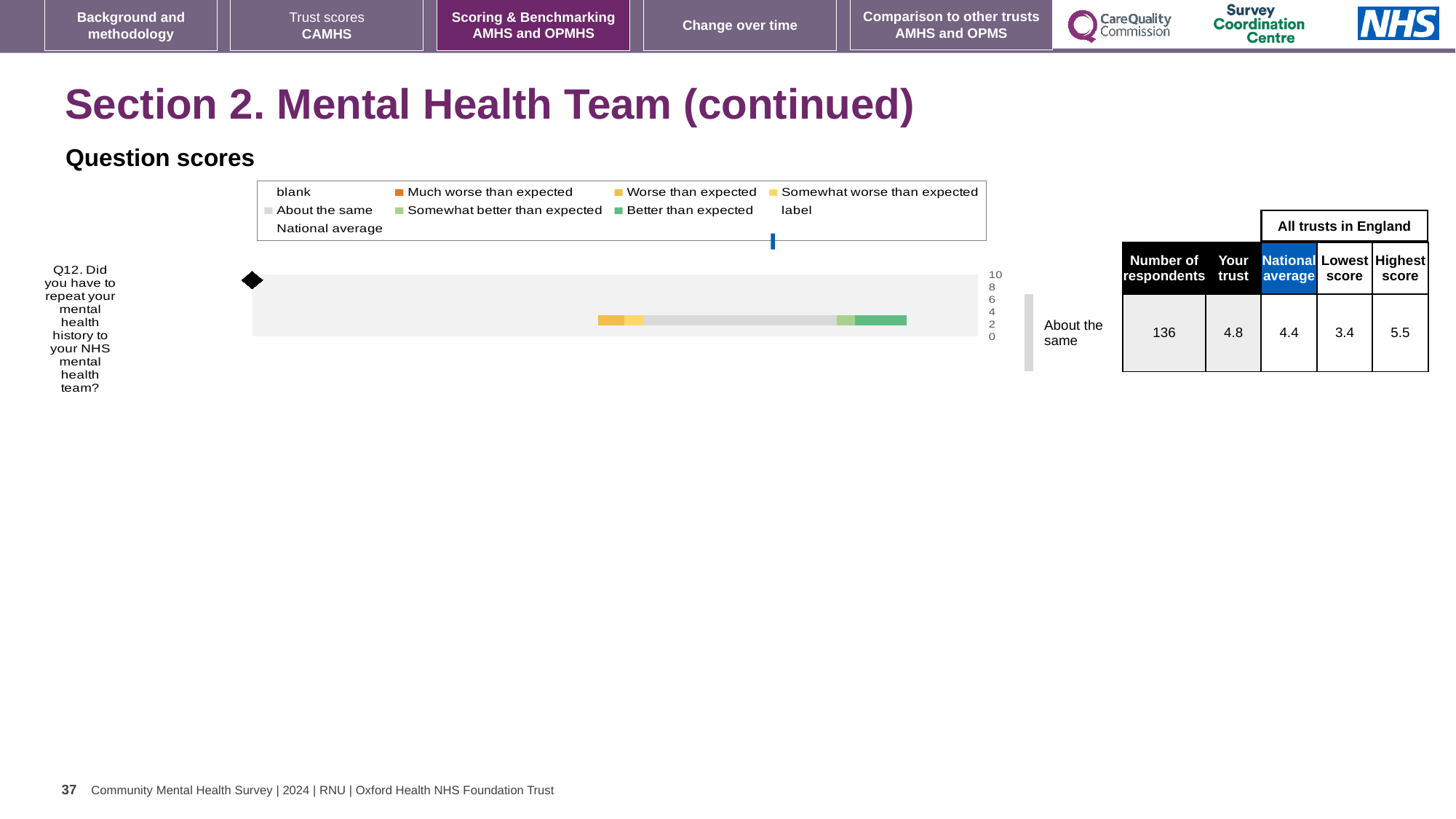
What is the national average score for Q12? 4.4 What benchmark category is the trust's Q12 score placed in? About the same What is the difference between the trust's score and the national average for Q12? 0.4 Which question is shown on the chart? Q12. Did you have to repeat your mental health history to your NHS mental health team? What is the trust's score for Q12? 4.8 What is the difference between the highest and lowest scores among all trusts in England for Q12? 2.1 How many respondents answered Q12? 136 Which is larger for Q12, the trust's score or the national average? Your trust What is the highest score among all trusts in England for Q12? 5.5 How many questions are plotted on the chart? 1 What kind of chart is used to show the Q12 question score? bar chart What is the lowest score among all trusts in England for Q12? 3.4